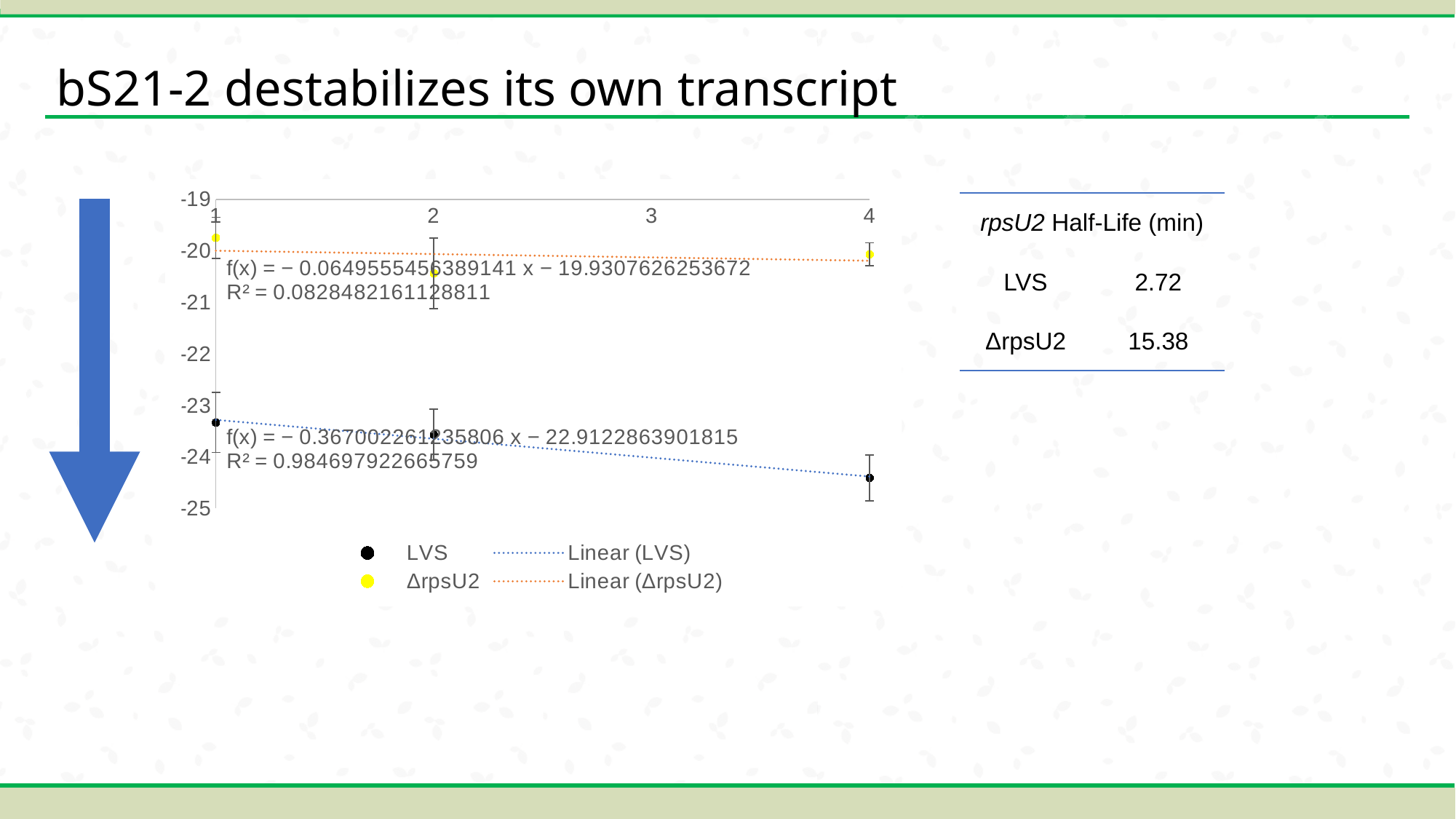
What is the intercept in the trendline equation for ΔrpsU2? −19.9307626253672 What kind of chart is shown on the slide? scatter chart At x = 4, which series has the higher plotted value, LVS or ΔrpsU2? ΔrpsU2 What is the slope (coefficient of x) in the trendline equation for LVS? −0.367002261235806 Do the LVS values rise or fall as x increases from 1 to 4? fall Is the ΔrpsU2 value at x = 1 greater or less than -20? greater What is the R² value printed for the LVS trendline? 0.984697922665759 How many entries does the chart legend list? 4 What is the R² value printed for the ΔrpsU2 trendline? 0.0828482161128811 Which series has the higher R² value, LVS or ΔrpsU2? LVS What colour are the ΔrpsU2 markers in the chart? yellow Is the LVS value at x = 4 greater or less than -24? less